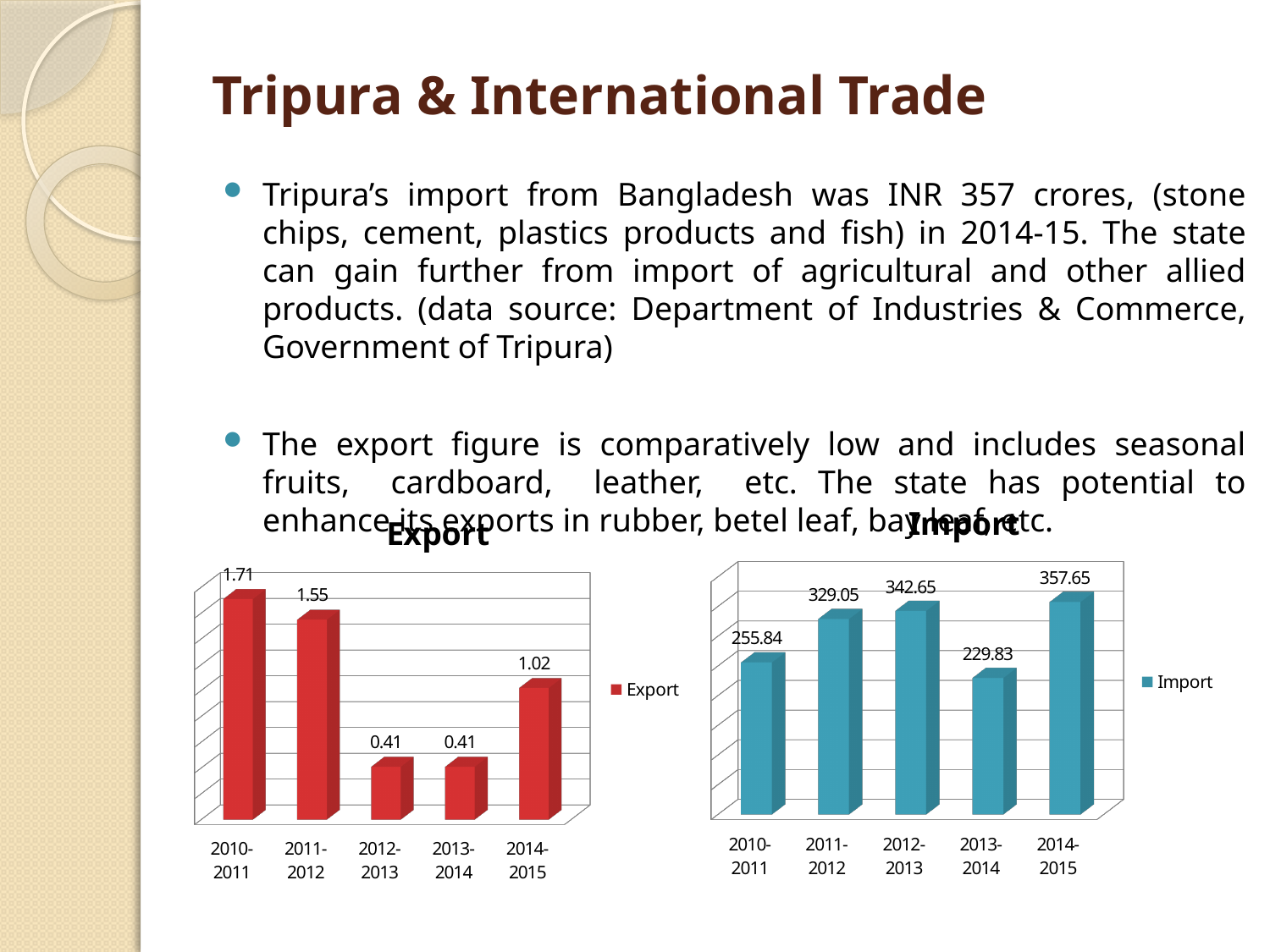
In the Export chart, what is the difference between the values for 2010-2011 and 2014-2015? 0.69 In the Import chart, which year has the lowest import value? 2013-2014 In the Import chart, which year has the highest import value? 2014-2015 In the Import chart, what is the difference between the values for 2014-2015 and 2010-2011? 101.81 How many series does the legend of the Export chart list? 1 In the Export chart, which year has the highest export value? 2010-2011 How many years are shown in the Export chart? 5 In the Import chart, what is the value for 2013-2014? 229.83 In the Import chart, which is larger, the value for 2011-2012 or the value for 2013-2014? 2011-2012 In the Export chart, which is larger, the value for 2011-2012 or the value for 2014-2015? 2011-2012 What kind of chart is the Import chart? bar chart In the Export chart, what is the value for 2010-2011? 1.71